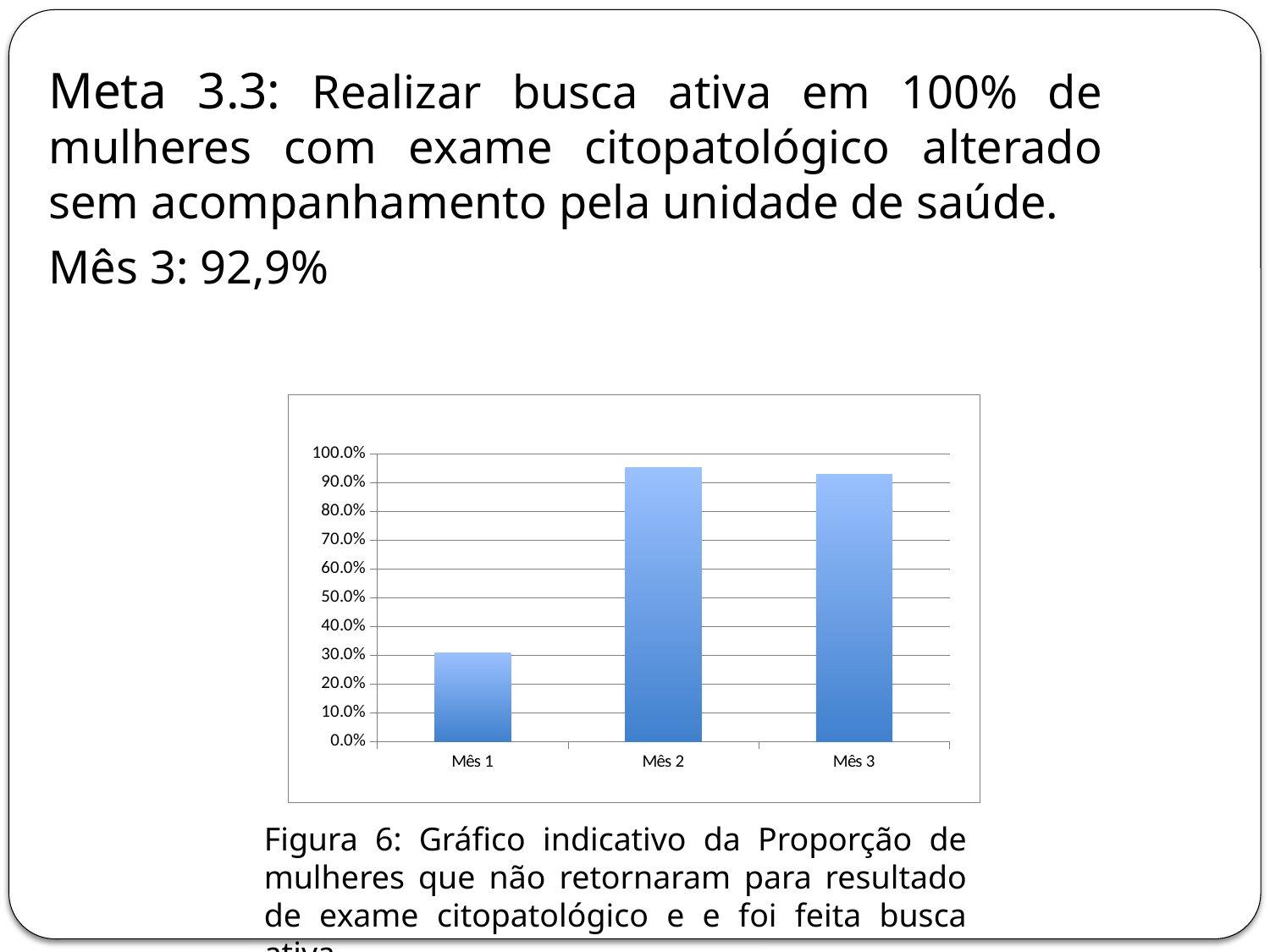
What is the highest tick value shown on the vertical axis of the chart? 100.0% How many categories (months) are plotted in the chart? 3 Is the value for Mês 1 greater or less than 50.0%? less What kind of chart is shown on the slide? bar chart Which is larger, the value for Mês 1 or the value for Mês 3? Mês 3 Is the value for Mês 2 greater or less than 90.0%? greater According to the slide text, what is the value for Mês 3? 92,9% Is the value for Mês 1 greater or less than 40.0%? less Which is larger, the value for Mês 1 or the value for Mês 2? Mês 2 Does the value rise or fall from Mês 1 to Mês 2? rise Which month has the lowest value in the chart? Mês 1